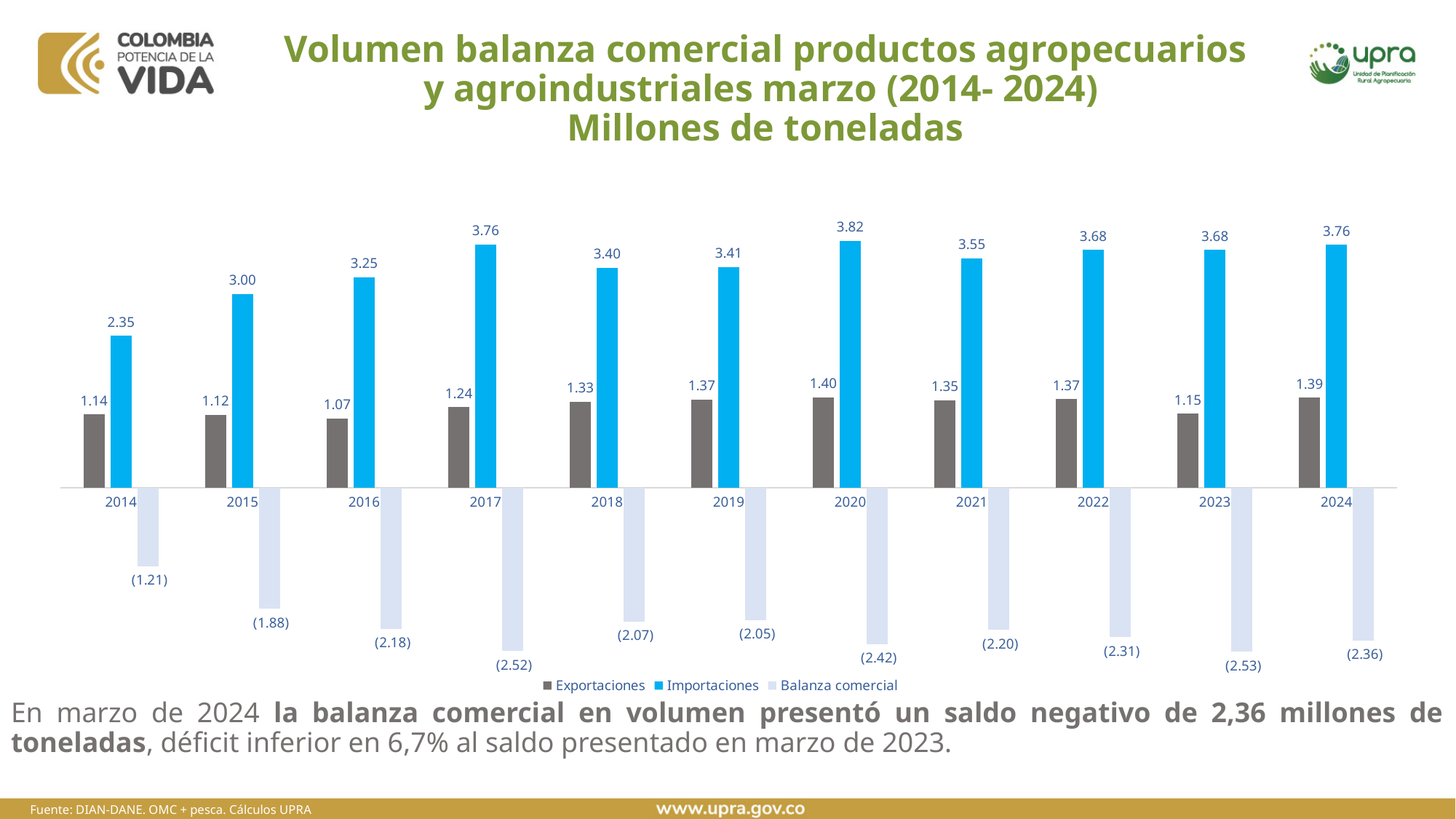
Which is larger, Importaciones in 2017 or Importaciones in 2018? 2017 What is the difference between Importaciones in 2024 and in 2014? 1.41 How many series does the legend list? 3 In which year is Importaciones highest? 2020 What is the value of Importaciones in 2020? 3.82 What is the value of Exportaciones in 2016? 1.07 What is the value of Balanza comercial in 2024? (2.36) In which year is Exportaciones lowest? 2016 What kind of chart is shown on the slide? Bar chart How many years are shown on the x axis? 11 Do the Importaciones values rise or fall from 2014 to 2017? Rise